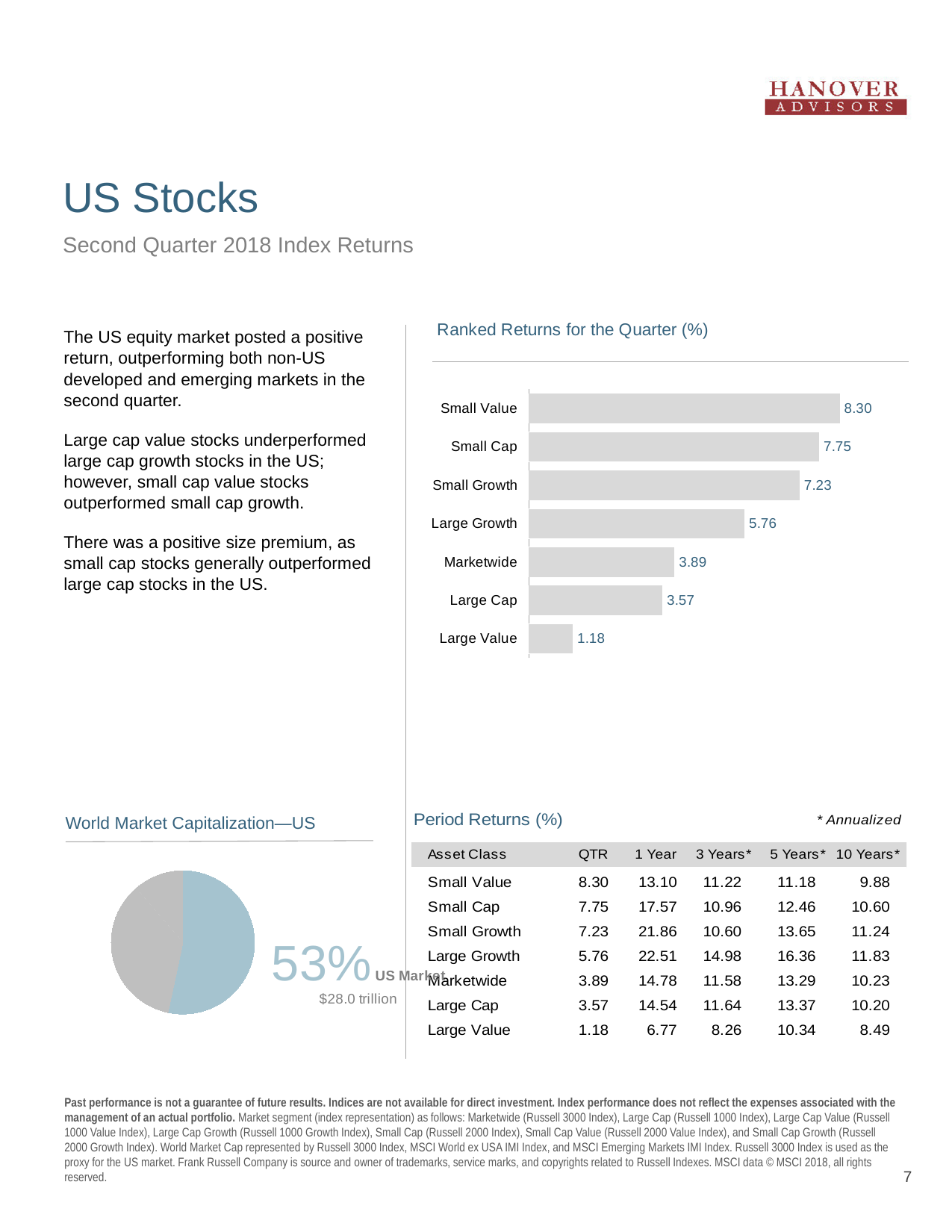
In the 'Ranked Returns for the Quarter (%)' chart, what is the value for Small Value? 8.30 In the 'Ranked Returns for the Quarter (%)' chart, which category has the lowest value? Large Value In the 'Ranked Returns for the Quarter (%)' chart, what is the difference between Large Growth and Large Value? 4.58 In the 'Ranked Returns for the Quarter (%)' chart, which category has the highest value? Small Value What kind of chart is 'World Market Capitalization—US'? Pie chart How many categories are shown in the 'Ranked Returns for the Quarter (%)' chart? 7 In the 'Ranked Returns for the Quarter (%)' chart, what is the value for Marketwide? 3.89 In the 'Ranked Returns for the Quarter (%)' chart, what is the difference between Small Cap and Small Growth? 0.52 In the 'Ranked Returns for the Quarter (%)' chart, what is the value for Large Cap? 3.57 In the 'Ranked Returns for the Quarter (%)' chart, which is larger, Large Growth or Marketwide? Large Growth What kind of chart is 'Ranked Returns for the Quarter (%)'? Bar chart In the 'World Market Capitalization—US' chart, what share of the pie does the US Market represent? 53%